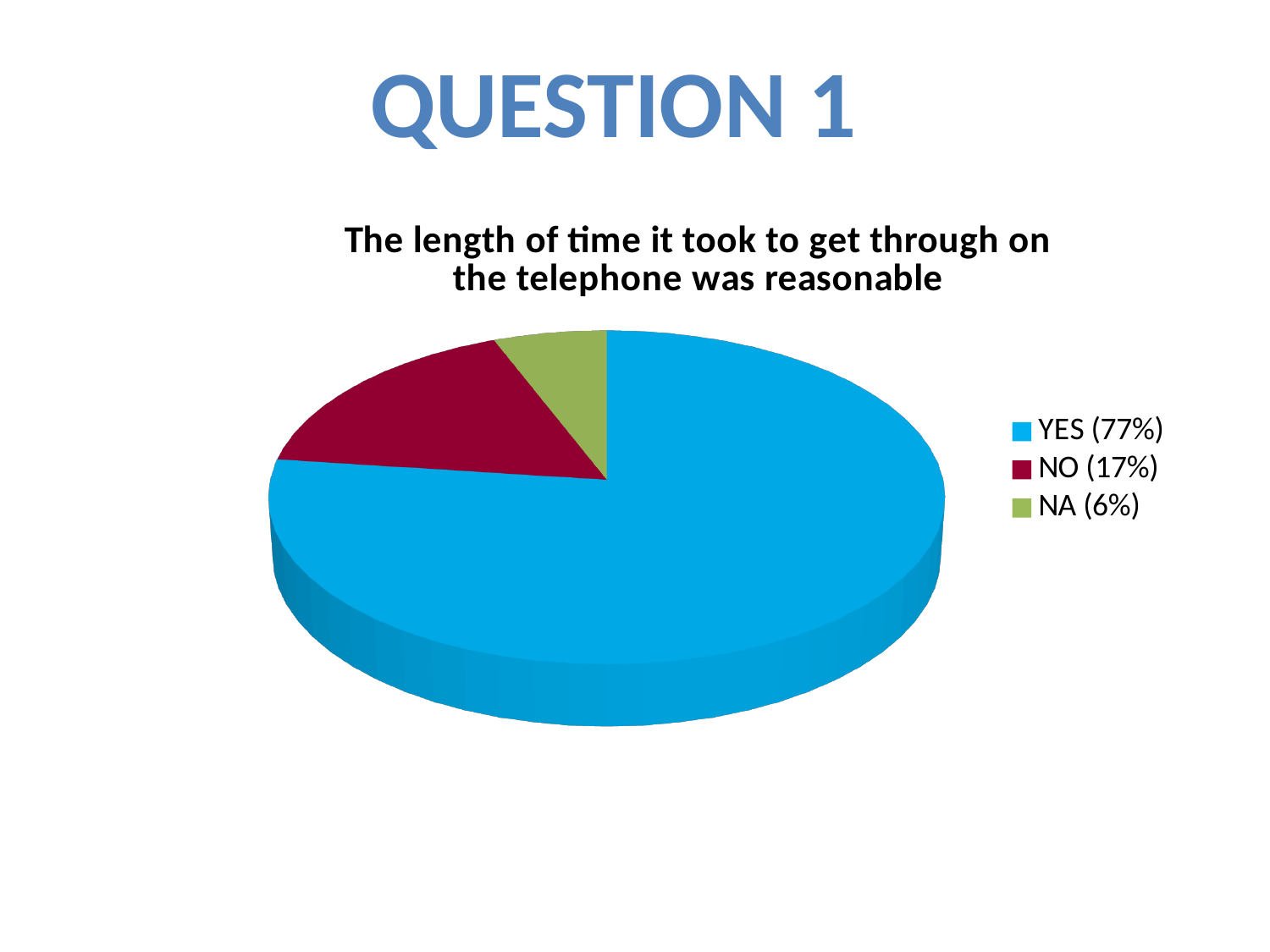
How many entries does the legend list? 3 What percentage of responses were YES? 77% How many slices does the pie chart have? 3 Which response has the largest share of the pie? YES What is the difference in percentage points between the YES and NO shares? 60 What percentage of responses were NO? 17% Which is larger, the NO share or the NA share? NO What colour is the YES slice? Blue What is the chart's title? The length of time it took to get through on the telephone was reasonable What percentage of responses were NA? 6% What kind of chart is shown on the slide? Pie chart Which response has the smallest share of the pie? NA